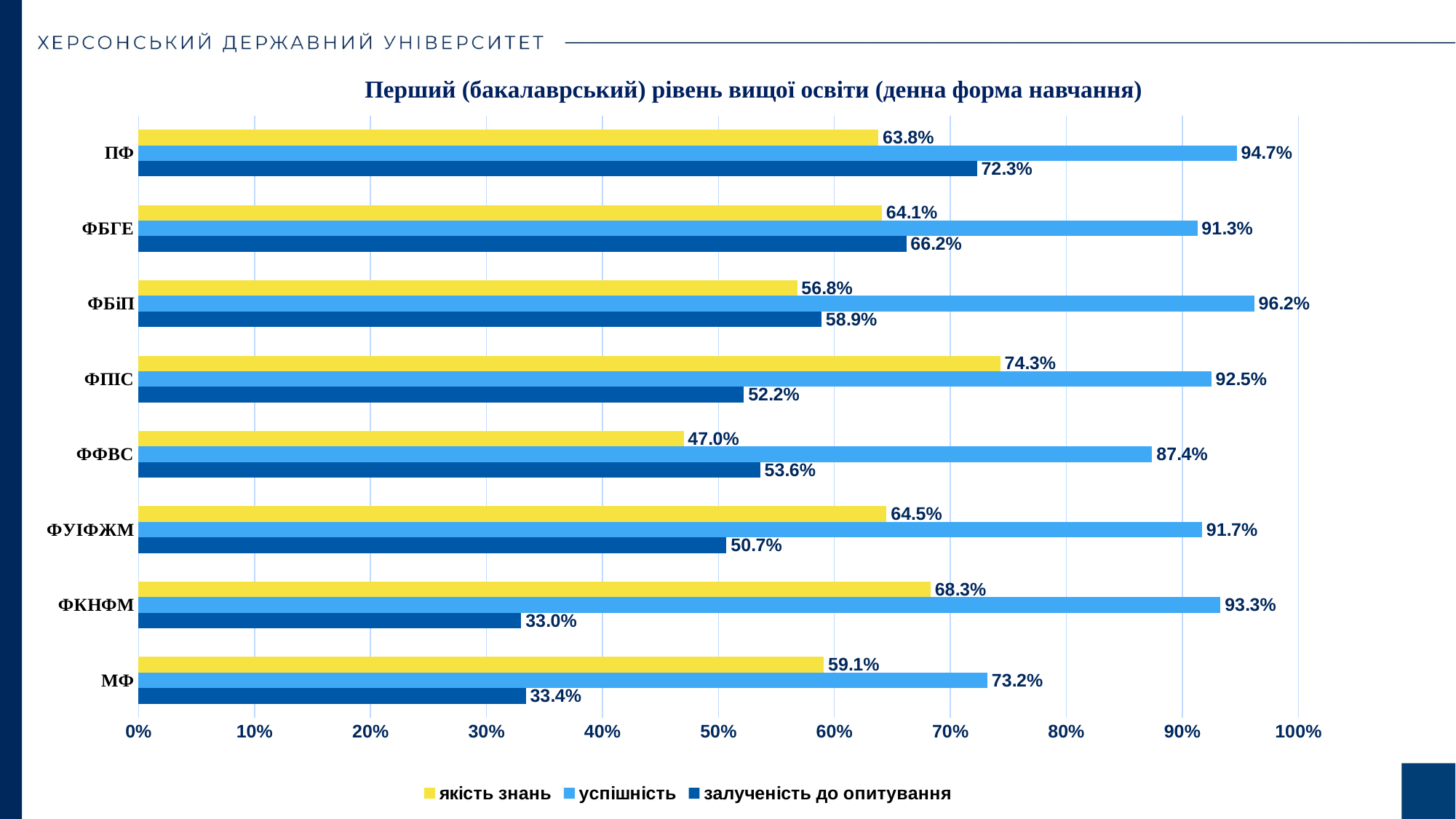
What is the якість знань value for ФФВС? 47.0% What is the title of the chart? Перший (бакалаврський) рівень вищої освіти (денна форма навчання) Which is larger for ФБГЕ: якість знань or залученість до опитування? залученість до опитування Which faculty has the highest залученість до опитування value? ПФ How many faculties (categories) are shown on the chart? 8 Which faculty has the highest якість знань value? ФПІС Which faculty has the lowest успішність value? МФ What is the успішність value for ФБіП? 96.2% What is the difference between the успішність and якість знань values for ПФ? 30.9 percentage points What type of chart is shown on the slide? bar chart How many series does the legend list? 3 What is the залученість до опитування value for ФКНФМ? 33.0%